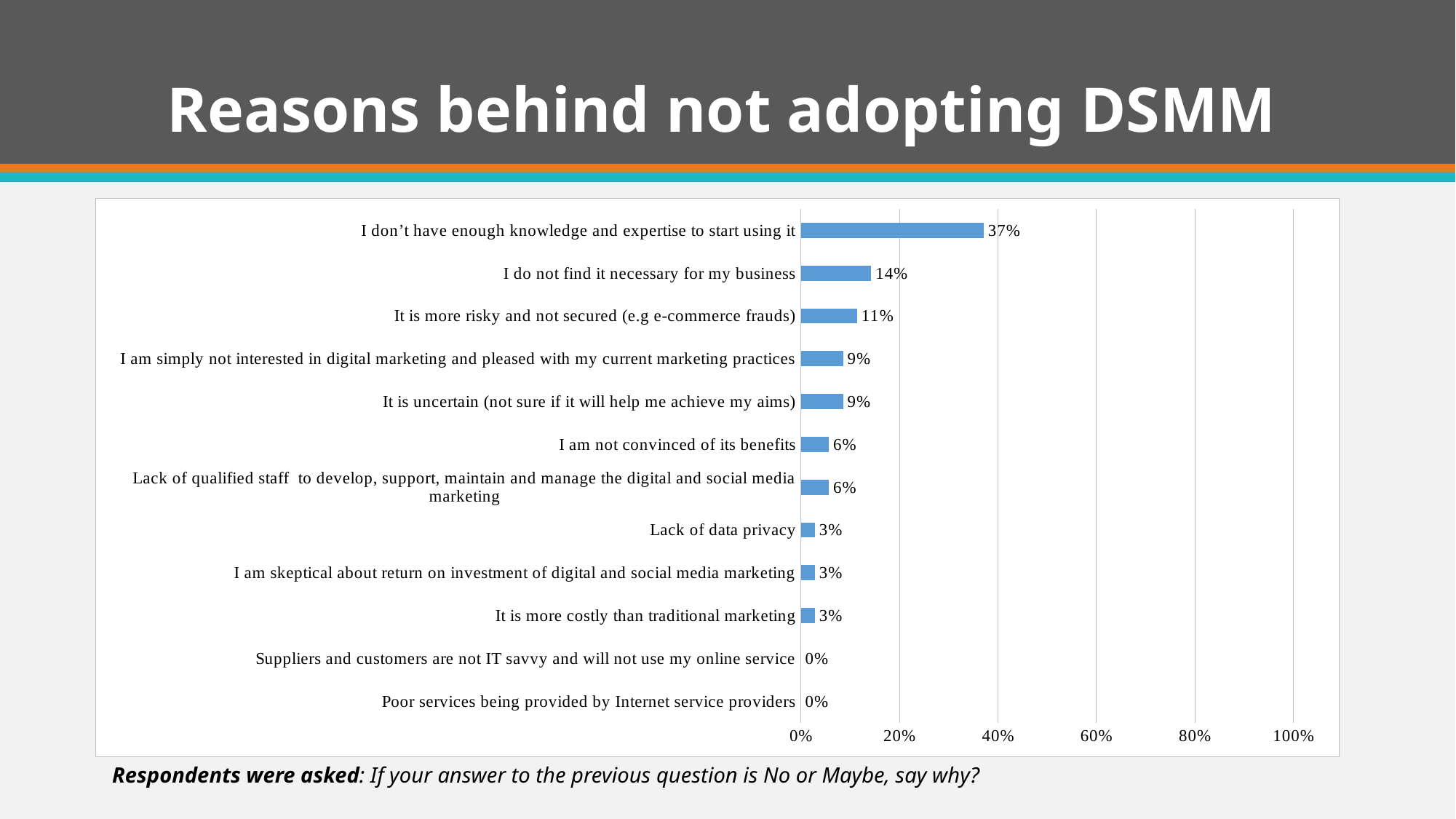
How many categories have a value of 0%? 2 Which reason has the highest percentage? I don't have enough knowledge and expertise to start using it What percentage of respondents said "I don't have enough knowledge and expertise to start using it"? 37% What is the value for "Poor services being provided by Internet service providers"? 0% How many reasons (categories) are listed in the chart? 12 Which is larger: "It is more risky and not secured (e.g e-commerce frauds)" or "I am not convinced of its benefits"? It is more risky and not secured (e.g e-commerce frauds) Is the value for "I don't have enough knowledge and expertise to start using it" greater or less than 40%? less What is the value for "It is more risky and not secured (e.g e-commerce frauds)"? 11% What is the value for "Lack of data privacy"? 3% What is the value for "I do not find it necessary for my business"? 14% What kind of chart is shown on the slide? bar chart What is the difference between "I don't have enough knowledge and expertise to start using it" and "I do not find it necessary for my business"? 23%